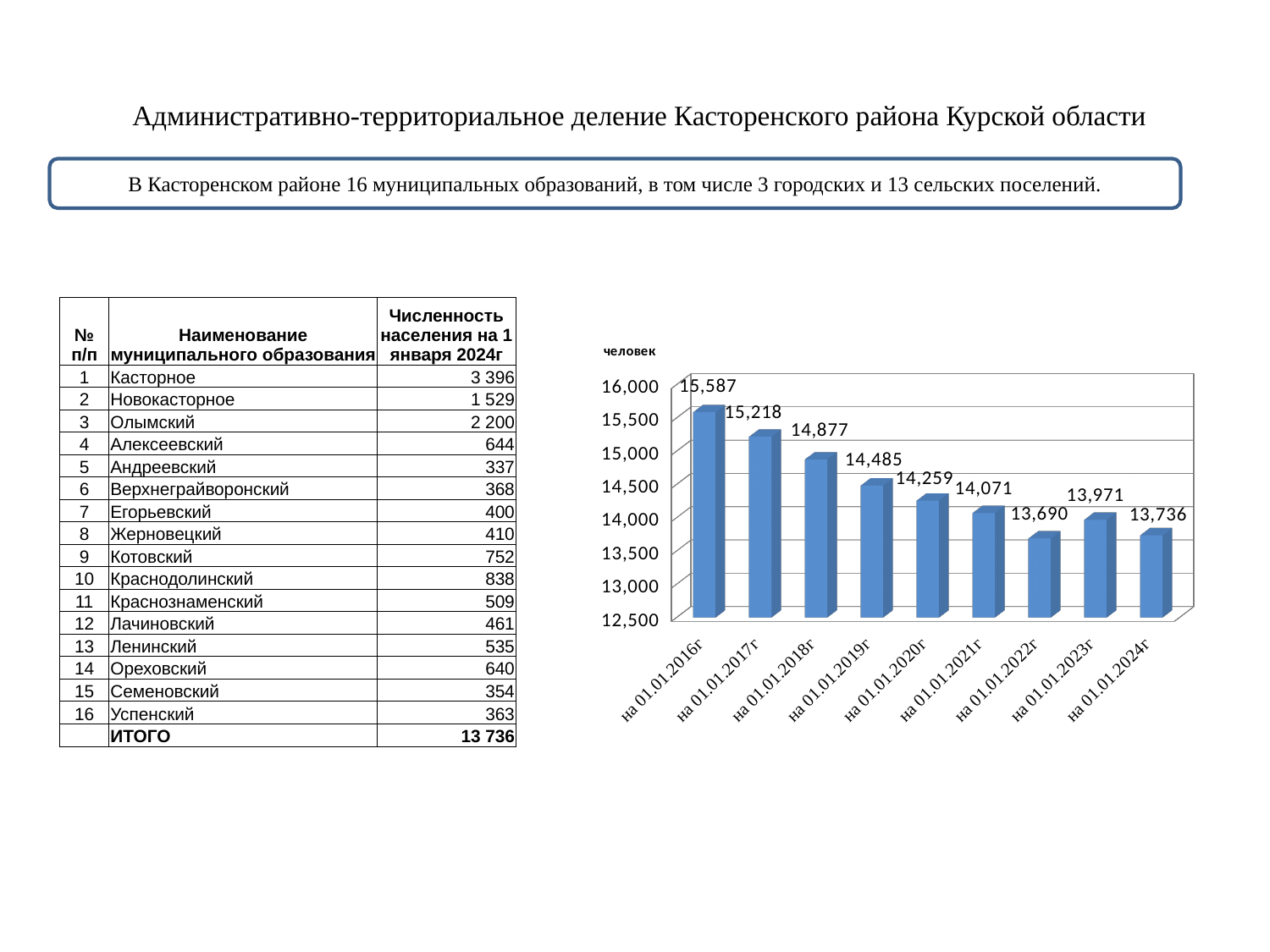
What kind of chart is shown on the slide? bar chart What is the value for на 01.01.2024г? 13,736 What is the difference between the values for на 01.01.2016г and на 01.01.2024г? 1,851 What is the value for на 01.01.2020г? 14,259 Is the value for на 01.01.2018г greater or less than 15,000? less Which is larger, the value for на 01.01.2023г or the value for на 01.01.2024г? на 01.01.2023г What is the value for на 01.01.2016г? 15,587 Which category has the highest value? на 01.01.2016г Do the values generally rise or fall from на 01.01.2016г to на 01.01.2022г? fall What is the difference between the values for на 01.01.2022г and на 01.01.2023г? 281 How many bars are shown in the chart? 9 Which category has the lowest value? на 01.01.2022г